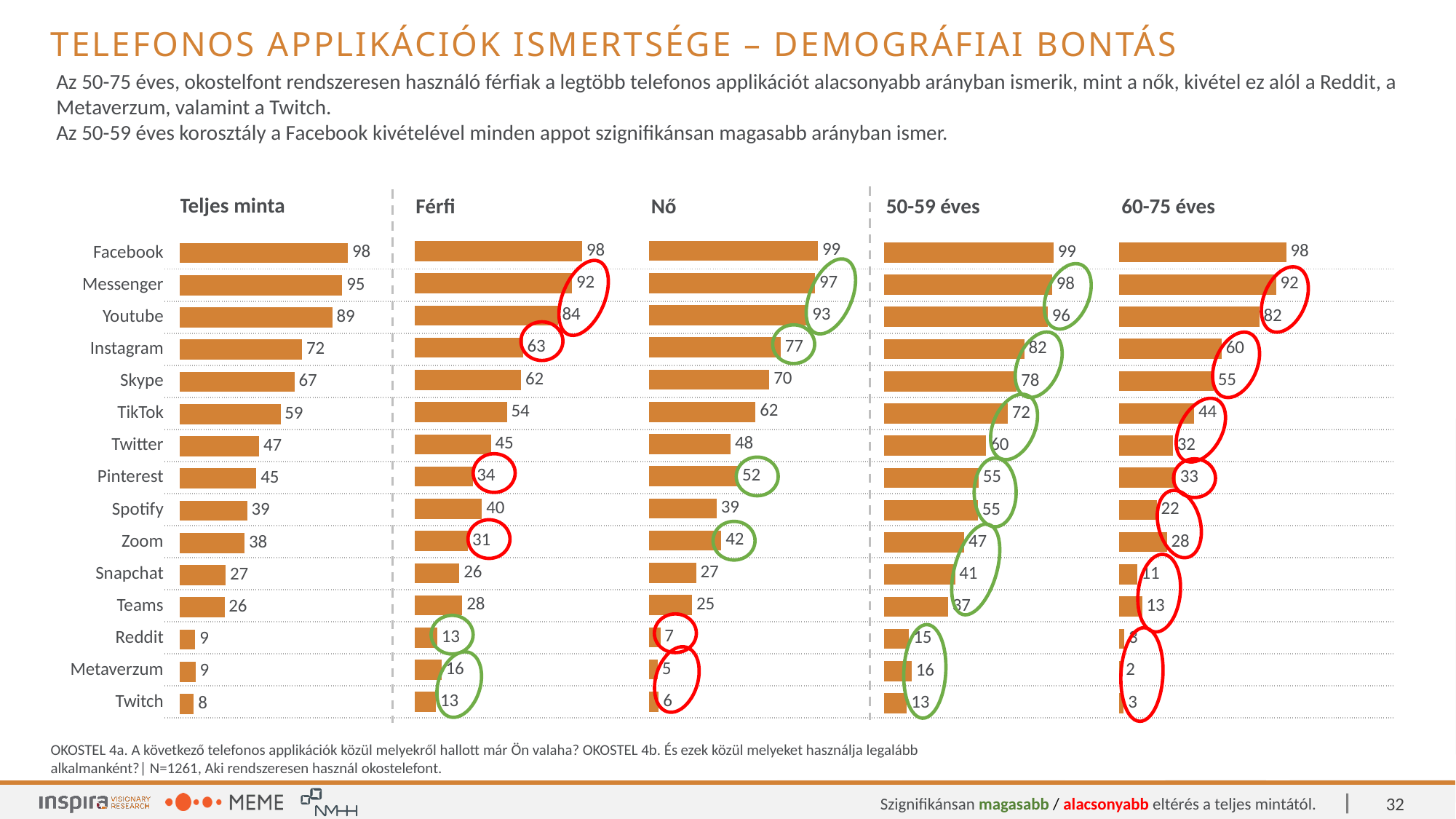
What kind of chart is used for the "50-59 éves" data? Bar chart In the "Férfi" chart, what is the value for Pinterest? 34 In the "50-59 éves" chart, what is the value for TikTok? 72 In the "60-75 éves" chart, what is the value for Snapchat? 11 What is the difference between the "Nő" and "Férfi" values for Instagram? 14 In the "Teljes minta" chart, which app has the highest value? Facebook In the "60-75 éves" chart, which app has the lowest value? Metaverzum In the "Nő" chart, what is the value for Zoom? 42 How many separate bar charts are shown on the slide? 5 In the "Teljes minta" chart, what is the value for Instagram? 72 How many apps are listed in the "Teljes minta" chart? 15 Which is larger: the "Férfi" value for Reddit or the "Nő" value for Reddit? Férfi